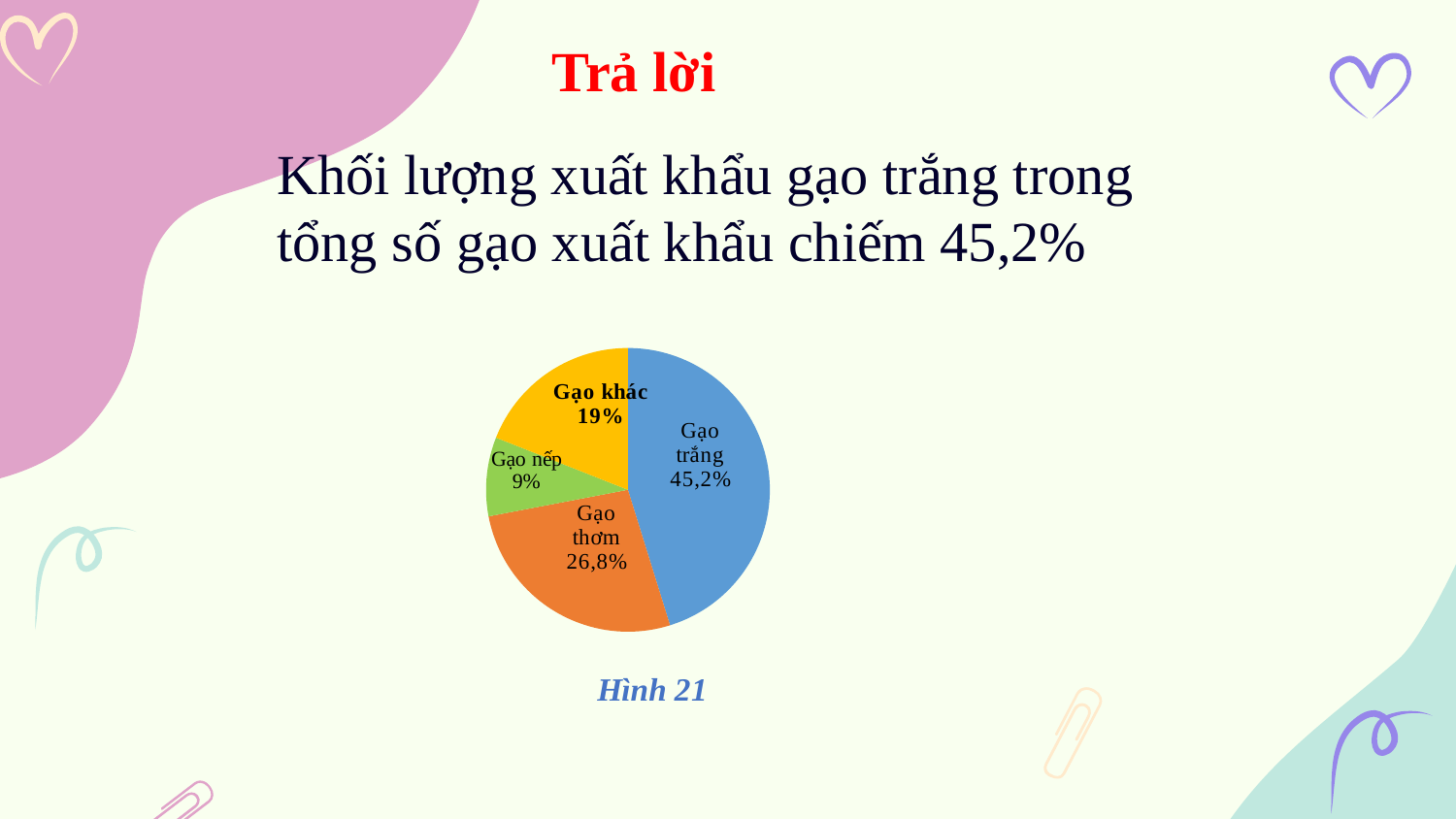
How many slices does the pie chart have? 4 Which category has the largest slice of the pie? Gạo trắng What is the value shown for Gạo khác? 19% Which category has the smallest slice of the pie? Gạo nếp What is the difference between the shares of Gạo trắng and Gạo thơm? 18,4% What type of chart is shown on the slide? Pie chart What percentage is labelled for Gạo nếp? 9% What is the value shown for Gạo thơm? 26,8% What is the difference between the shares of Gạo khác and Gạo nếp? 10% What is the caption written below the chart? Hình 21 Which is larger, the share of Gạo thơm or the share of Gạo khác? Gạo thơm What share of the pie does Gạo trắng represent? 45,2%